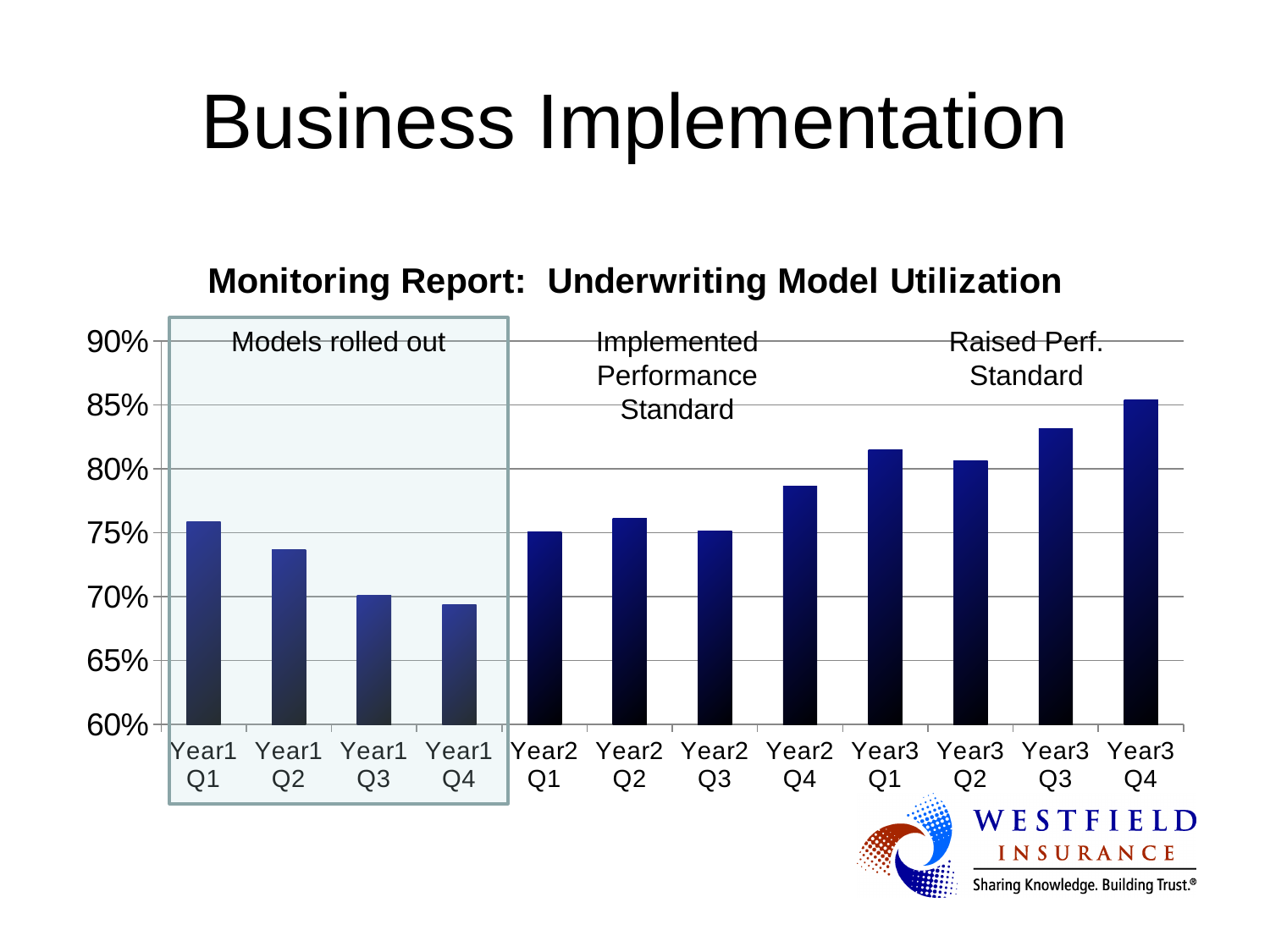
Is the value for Year2 Q4 greater or less than 75%? greater Which is larger, the value for Year1 Q1 or the value for Year3 Q4? Year3 Q4 Which quarter has the highest utilization value? Year3 Q4 How many bars (quarters) are plotted in the chart? 12 What is the title of the chart? Monitoring Report: Underwriting Model Utilization Is the value for Year3 Q1 greater or less than 80%? greater Is the value for Year2 Q2 greater or less than 80%? less What annotation label appears above the shaded Year1 section of the chart? Models rolled out What kind of chart is shown on the slide? Bar chart Do the values rise or fall across the four quarters of Year1? fall